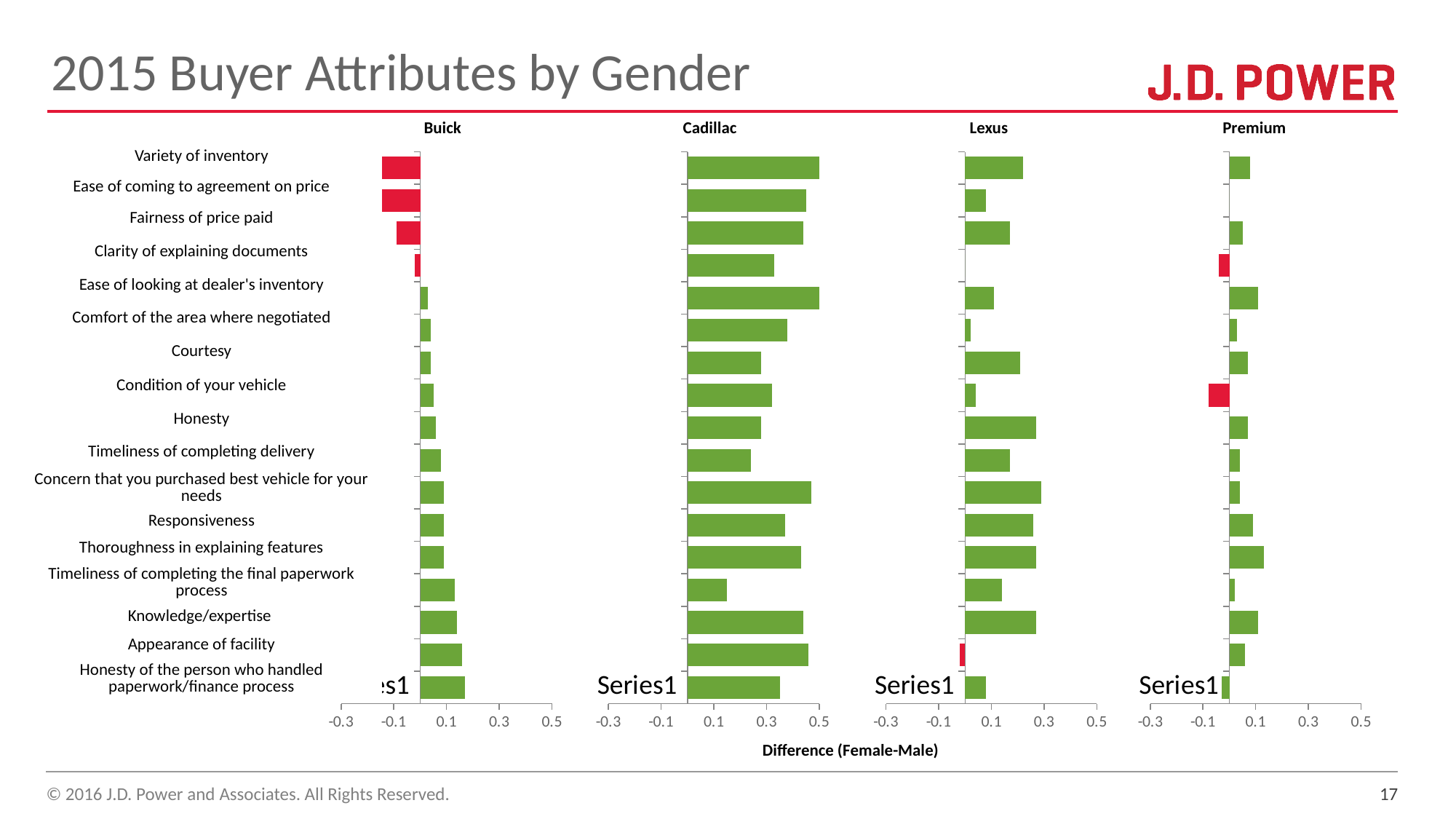
In the Buick chart, is the value for Variety of inventory greater or less than -0.1? less In the Cadillac chart, which attribute has the lowest value? Timeliness of completing the final paperwork process In the Lexus chart, is the value for Honesty greater or less than 0.1? greater Which is larger: the value for Variety of inventory in the Cadillac chart or in the Lexus chart? Cadillac How many attributes (categories) are listed down the left side of the charts? 17 In the Premium chart, which attribute has the lowest value? Condition of your vehicle How many bars in the Buick chart are negative (shown in red)? 4 In the Cadillac chart, is the value for Timeliness of completing the final paperwork process greater or less than 0.3? less In the Lexus chart, which attribute has the lowest value? Appearance of facility What is the x-axis title shown beneath the charts? Difference (Female-Male) What kind of chart is used for the Buick panel? Bar chart